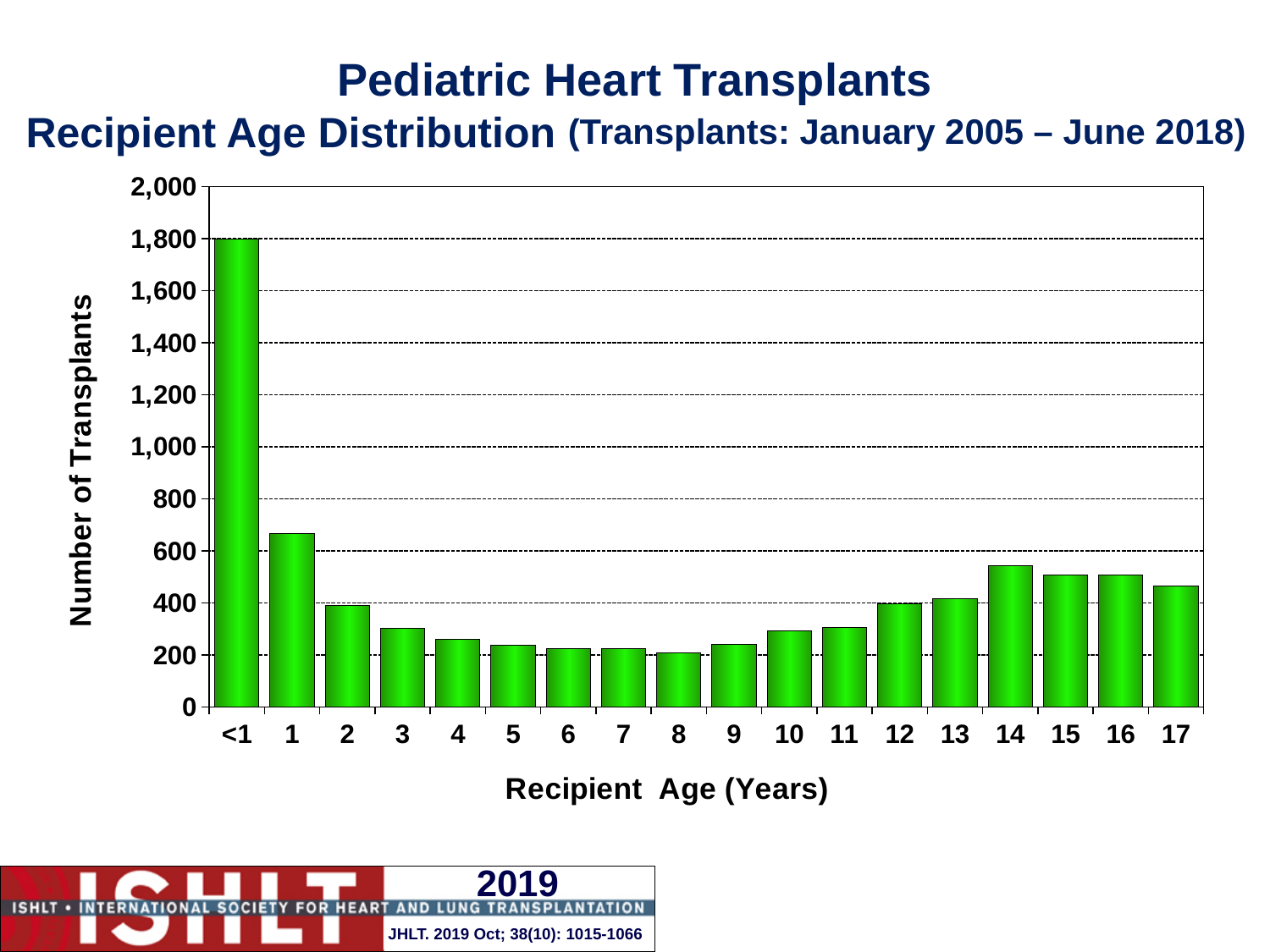
Is the number of transplants for recipients aged 1 greater or less than 600? greater Is the number of transplants for recipients aged 10 greater or less than 400? less What kind of chart is shown on the slide? bar chart What is the label of the y axis? Number of Transplants Is the number of transplants for recipients aged 14 greater or less than 600? less Which has more transplants: recipients aged 1 or recipients aged 17? 1 How many recipient age categories are shown on the x axis? 18 Do the number of transplants rise or fall from age 8 to age 14? rise Which has more transplants: recipients aged 14 or recipients aged 10? 14 Which recipient age category has the highest number of transplants? <1